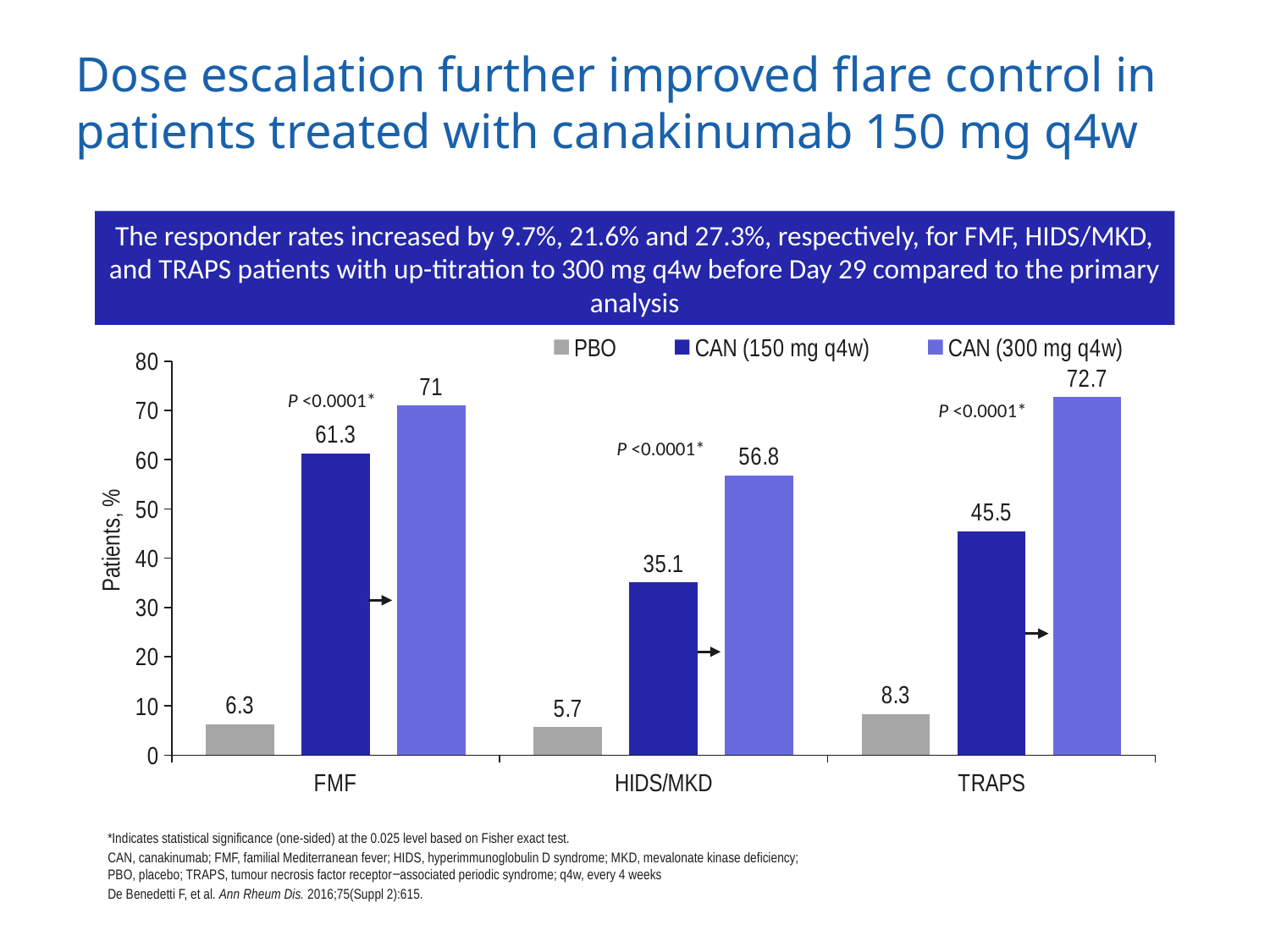
Which disease group has the lowest value for CAN (150 mg q4w)? HIDS/MKD Which is larger: the PBO value for TRAPS or the PBO value for FMF? PBO value for TRAPS What is the value for PBO in the HIDS/MKD group? 5.7 Which series is shown in grey in the legend? PBO How many disease groups are shown on the x axis? 3 How many series does the legend list? 3 What is the value for CAN (150 mg q4w) in the FMF group? 61.3 What kind of chart is shown on the slide? Bar chart What is the difference between the CAN (300 mg q4w) and CAN (150 mg q4w) values in the HIDS/MKD group? 21.7 What is the value for CAN (300 mg q4w) in the TRAPS group? 72.7 Which disease group has the highest value for CAN (300 mg q4w)? TRAPS What is the label of the y axis? Patients, %